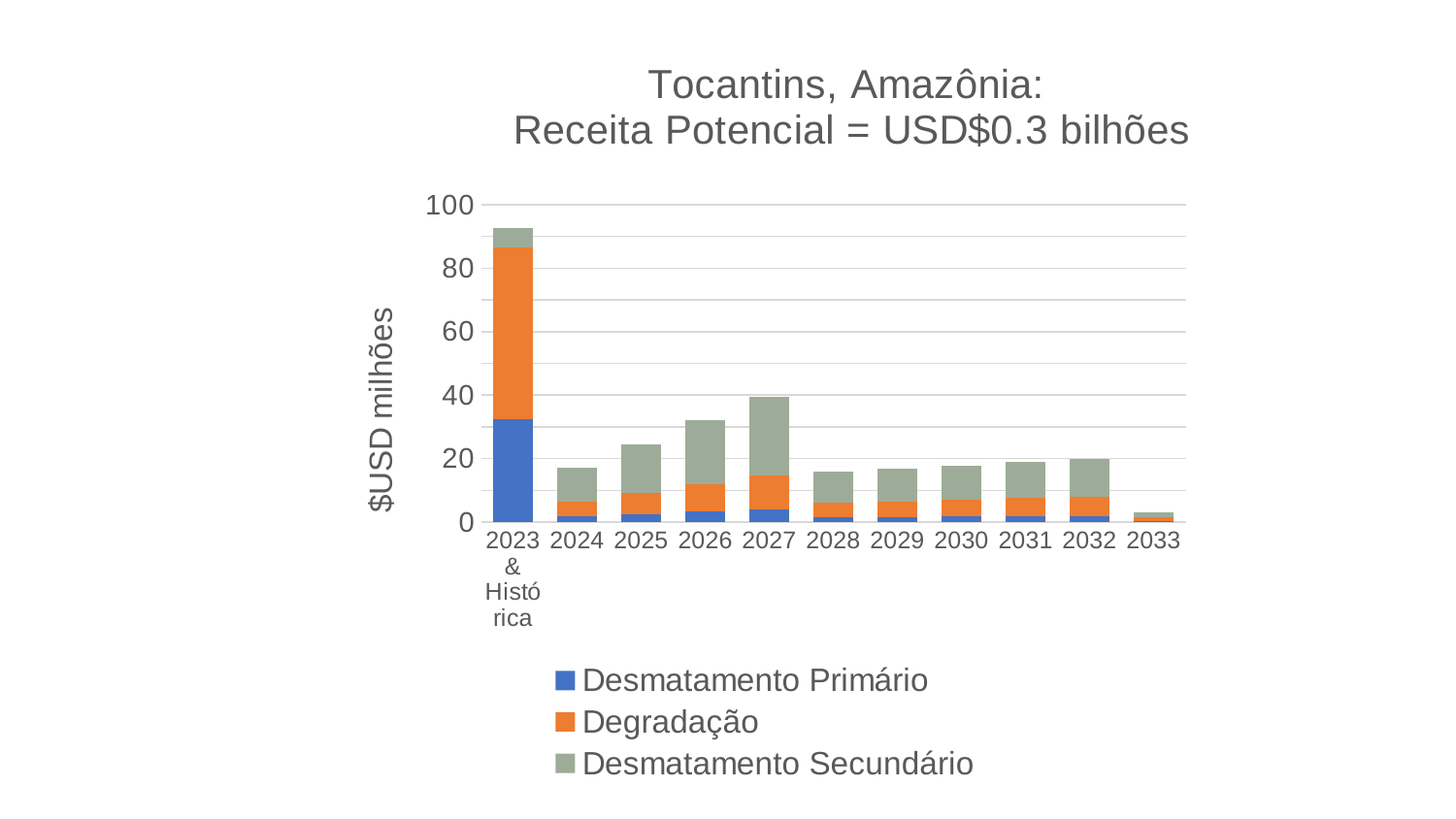
Which has the larger total bar, 2024 or 2025? 2025 Which category has the tallest stacked bar? 2023 & Histórica Which has the larger total bar, 2026 or 2027? 2027 Is the total value for 2027 greater or less than 20? greater How many categories are shown along the x axis? 11 From 2024 to 2027, do the total bar values rise or fall? rise What is the label on the vertical axis? $USD milhões What kind of chart is shown on the slide? Stacked bar chart How many series does the legend list? 3 Is the total value for 2023 & Histórica greater or less than 80? greater Which category has the shortest stacked bar? 2033 Is the total value for 2028 greater or less than 20? less